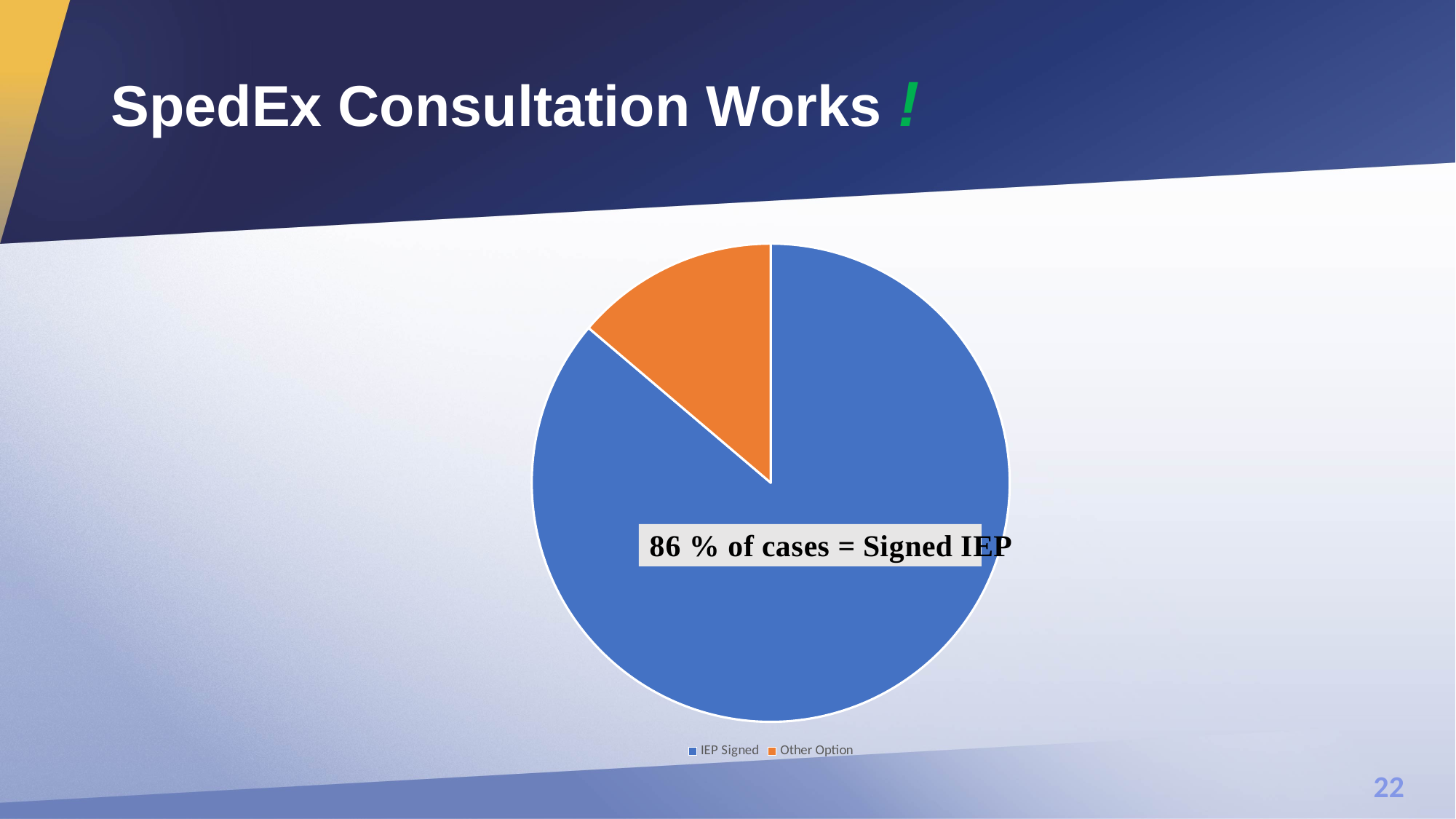
What colour is the IEP Signed slice in the pie chart? Blue Which category has the smallest slice of the pie chart? Other Option Which is larger in the pie chart, IEP Signed or Other Option? IEP Signed What share of cases does the Other Option slice represent? 14 % What share of cases does the IEP Signed slice represent? 86 % What are the two legend entries of the pie chart? IEP Signed and Other Option Which category has the largest slice of the pie chart? IEP Signed How many slices does the pie chart have? 2 What kind of chart is shown on the slide? Pie chart How many entries does the legend of the pie chart list? 2